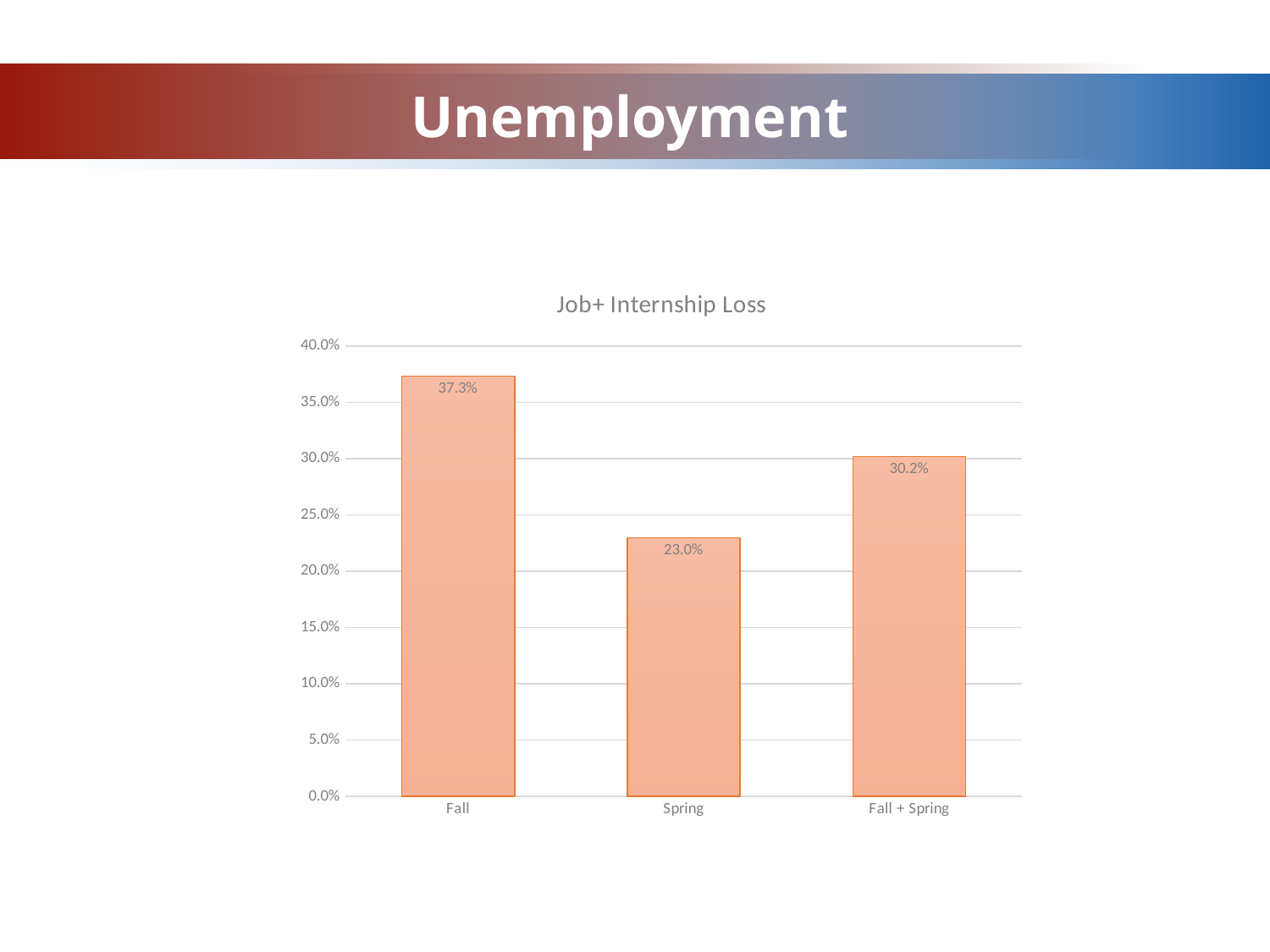
What is the value for Fall? 37.3% What is the difference between the values for Fall + Spring and Spring? 7.2% Is the value for Spring greater or less than 25.0%? less What kind of chart is shown on the slide? bar chart What is the difference between the values for Fall and Spring? 14.3% What is the value for Spring? 23.0% What is the value for Fall + Spring? 30.2% Which category has the highest value? Fall How many categories are shown on the x axis? 3 Which is larger, the value for Spring or the value for Fall + Spring? Fall + Spring What is the title of the chart? Job+ Internship Loss Which category has the lowest value? Spring